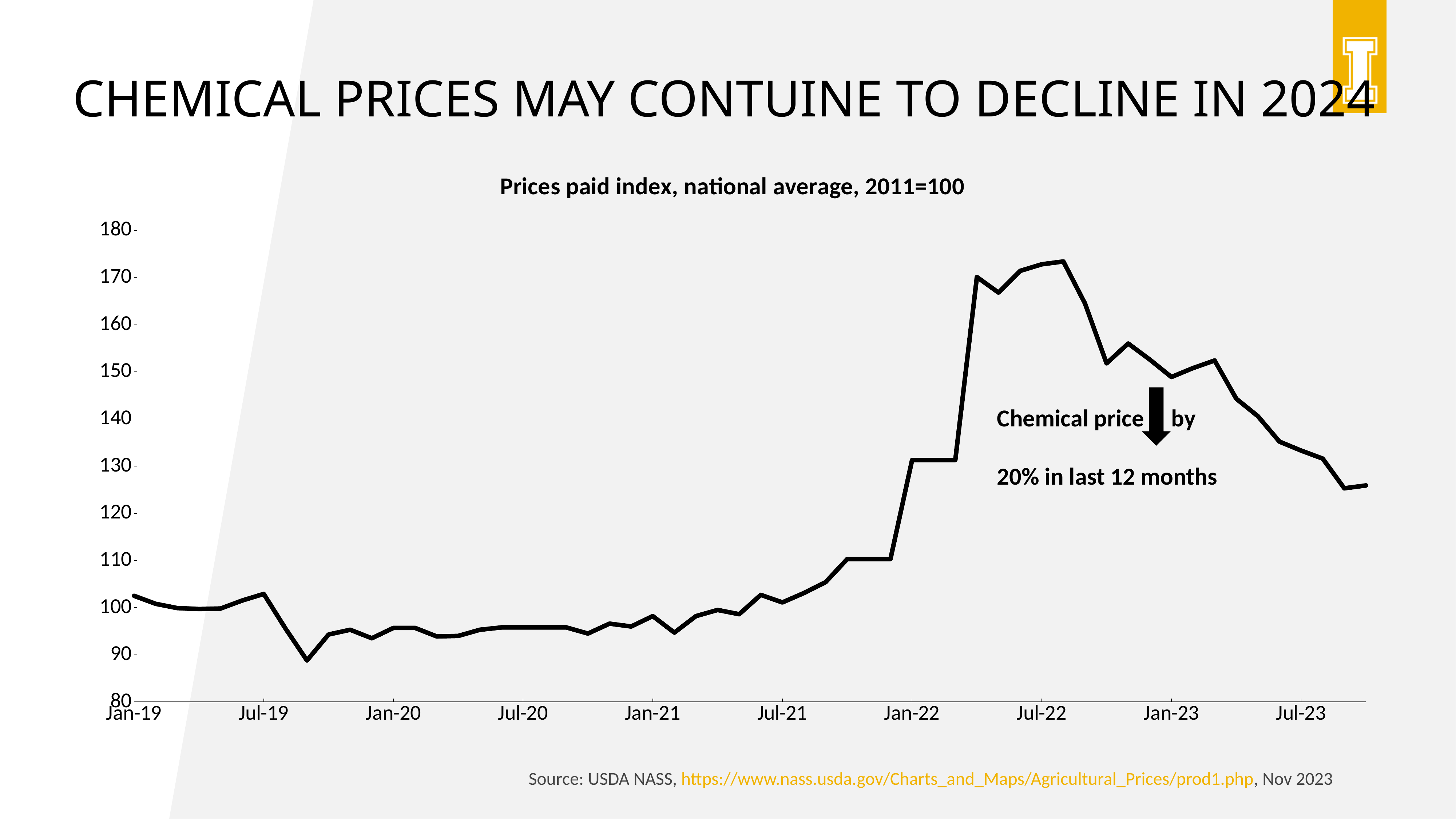
What kind of chart is shown on the slide? line chart How many labelled tick marks are on the x axis? 10 What is the title of the chart? Prices paid index, national average, 2011=100 How many lines (data series) are plotted on the chart? 1 Does the index rise or fall between Jan-22 and Jul-22? rise Is the value for Jul-22 greater or less than 160? greater Which is larger, the value at Jul-22 or the value at Jul-23? Jul-22 Is the value for Jan-22 greater or less than 100? greater Does the index rise or fall between Jul-22 and Jul-23? fall Is the value for Jul-23 greater or less than 140? less